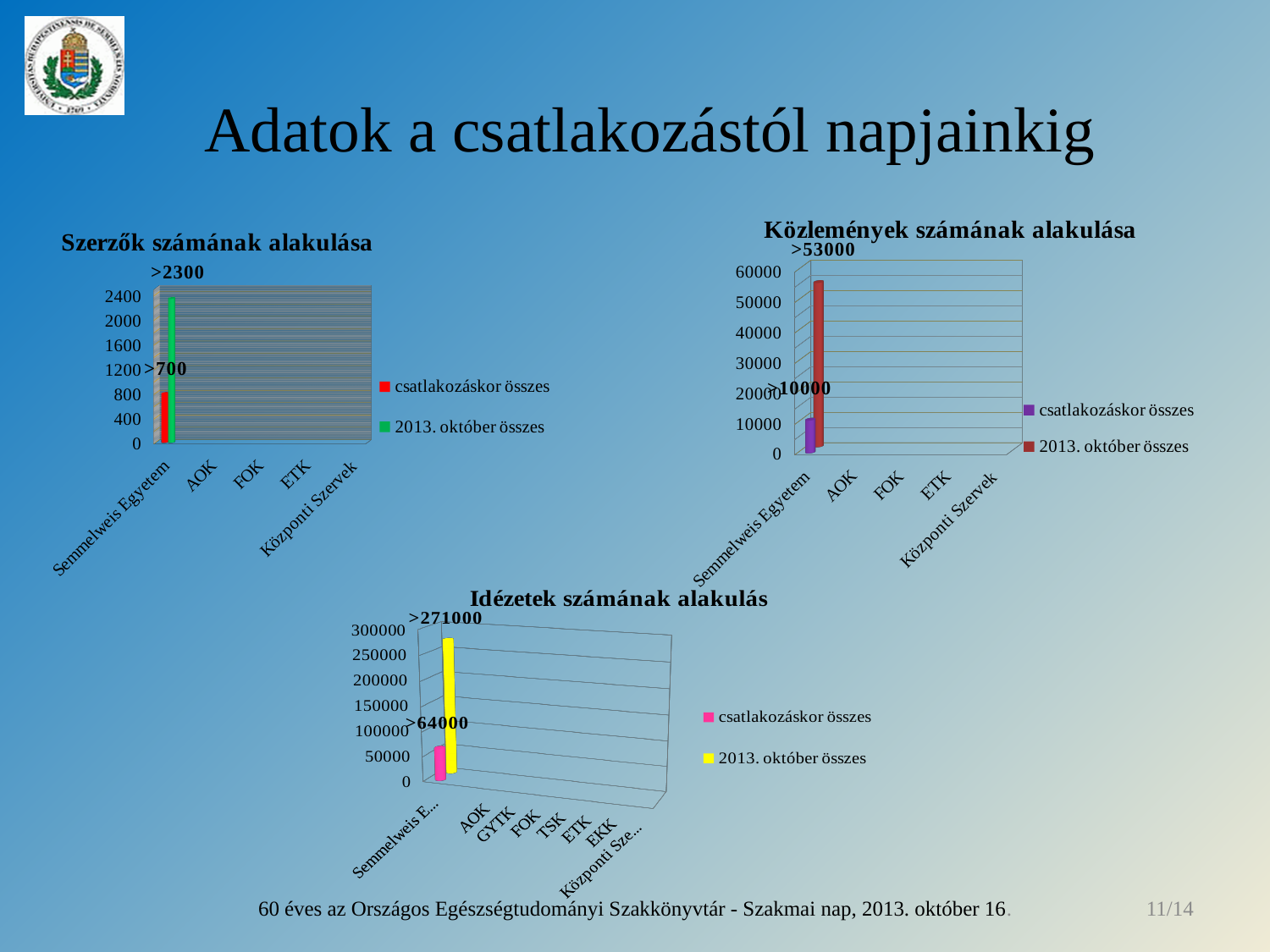
In the 'Szerzők számának alakulása' chart, is the 'csatlakozáskor összes' value for Semmelweis Egyetem greater or less than 1200? less In the 'Közlemények számának alakulása' chart, what data label is printed on the '2013. október összes' bar? >53000 In the 'Idézetek számának alakulás' chart, how many categories are shown on the x axis? 8 In the 'Idézetek számának alakulás' chart, what data label is printed on the 'csatlakozáskor összes' bar? >64000 In the 'Közlemények számának alakulása' chart, is the '2013. október összes' value for Semmelweis Egyetem greater or less than 40000? greater In the 'Szerzők számának alakulása' chart, what data label is printed on the '2013. október összes' bar for Semmelweis Egyetem? >2300 In the 'Közlemények számának alakulása' chart, which series has the larger value for Semmelweis Egyetem, 'csatlakozáskor összes' or '2013. október összes'? 2013. október összes In the 'Idézetek számának alakulás' chart, what colour is the '2013. október összes' series? yellow In the 'Szerzők számának alakulása' chart, what data label is printed on the 'csatlakozáskor összes' bar for Semmelweis Egyetem? >700 In the 'Szerzők számának alakulása' chart, how many series does the legend list? 2 How many charts are on the slide? 3 In the 'Szerzők számának alakulása' chart, what kind of chart is shown? bar chart